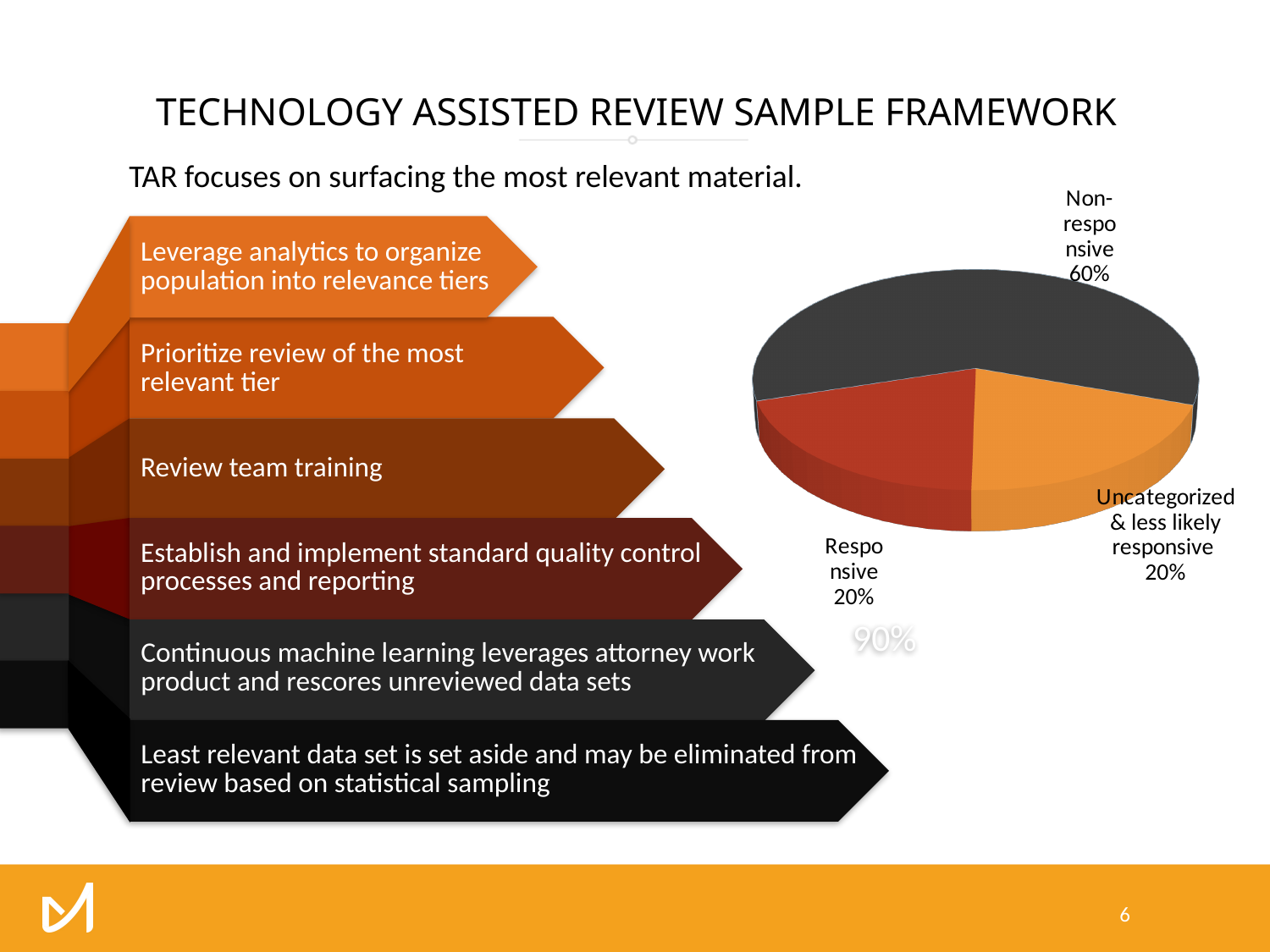
What is the combined share of the Responsive and Uncategorized & less likely responsive slices? 40% Is the Non-responsive share greater or less than 50%? greater What is the difference in percentage points between the Non-responsive slice and the Responsive slice? 40 Which is larger in the pie chart, Non-responsive or Responsive? Non-responsive What share of the pie is labelled Uncategorized & less likely responsive? 20% What share of the pie is labelled Non-responsive? 60% What share of the pie is labelled Responsive? 20% Which slice of the pie chart is the largest? Non-responsive How many slices does the pie chart have? 3 What colour is the Non-responsive slice of the pie chart? dark grey What colour is the Uncategorized & less likely responsive slice of the pie chart? orange What kind of chart is shown on the slide? pie chart